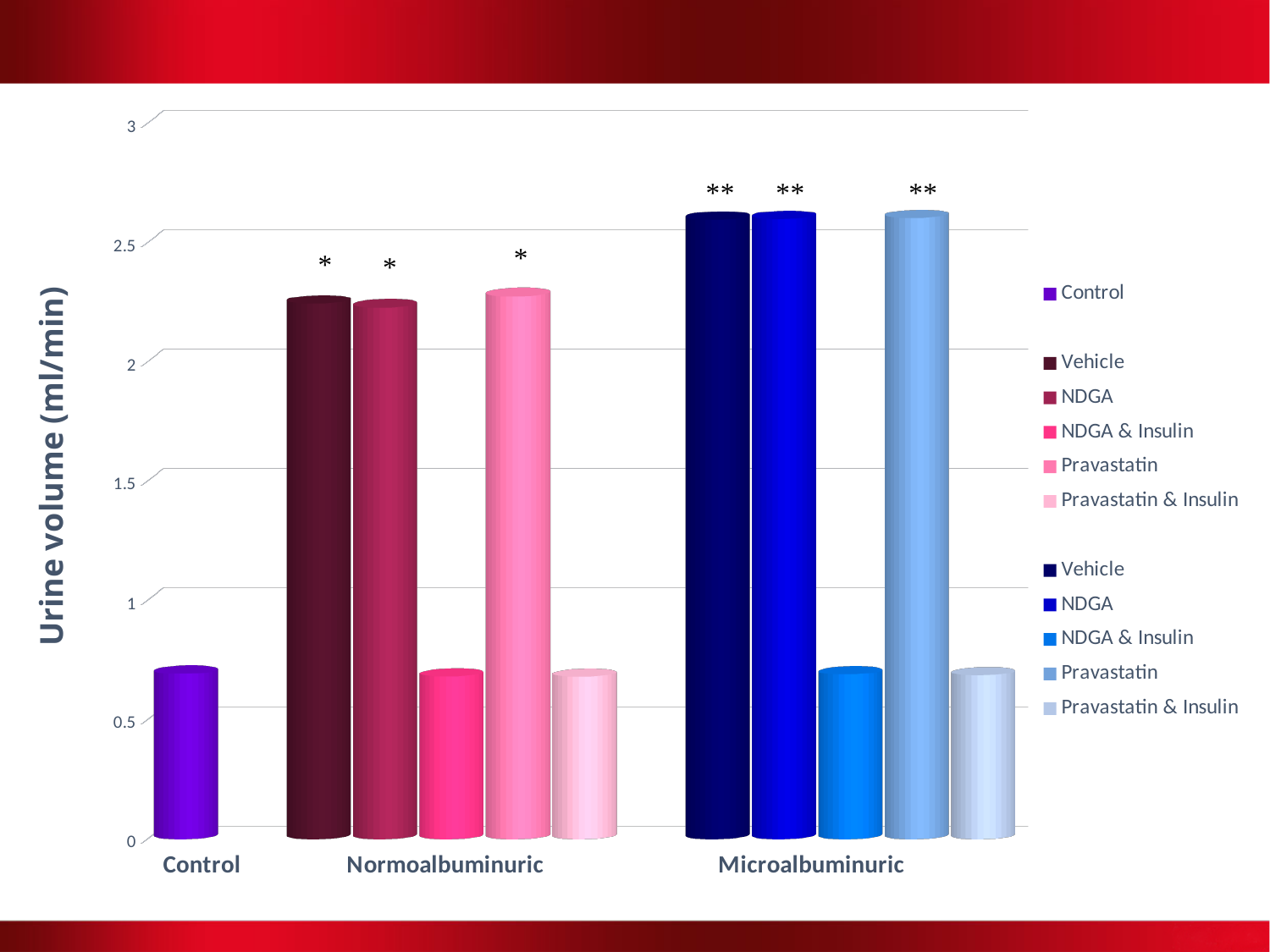
How many categories are labelled on the x axis? 3 Is the value for the Control bar greater or less than 1? less What is the title of the y axis? Urine volume (ml/min) Is the value for the Vehicle bar in the Microalbuminuric group greater or less than 2.5? greater What kind of chart is shown on the slide? Bar chart How many series does the legend list? 11 Which is larger: the Vehicle bar in the Normoalbuminuric group or the Vehicle bar in the Microalbuminuric group? Microalbuminuric Vehicle Is the value for the NDGA & Insulin bar in the Microalbuminuric group greater or less than 1? less Which is larger in the Normoalbuminuric group: the Pravastatin bar or the Pravastatin & Insulin bar? Pravastatin Which x-axis group contains the tallest bars on the chart? Microalbuminuric